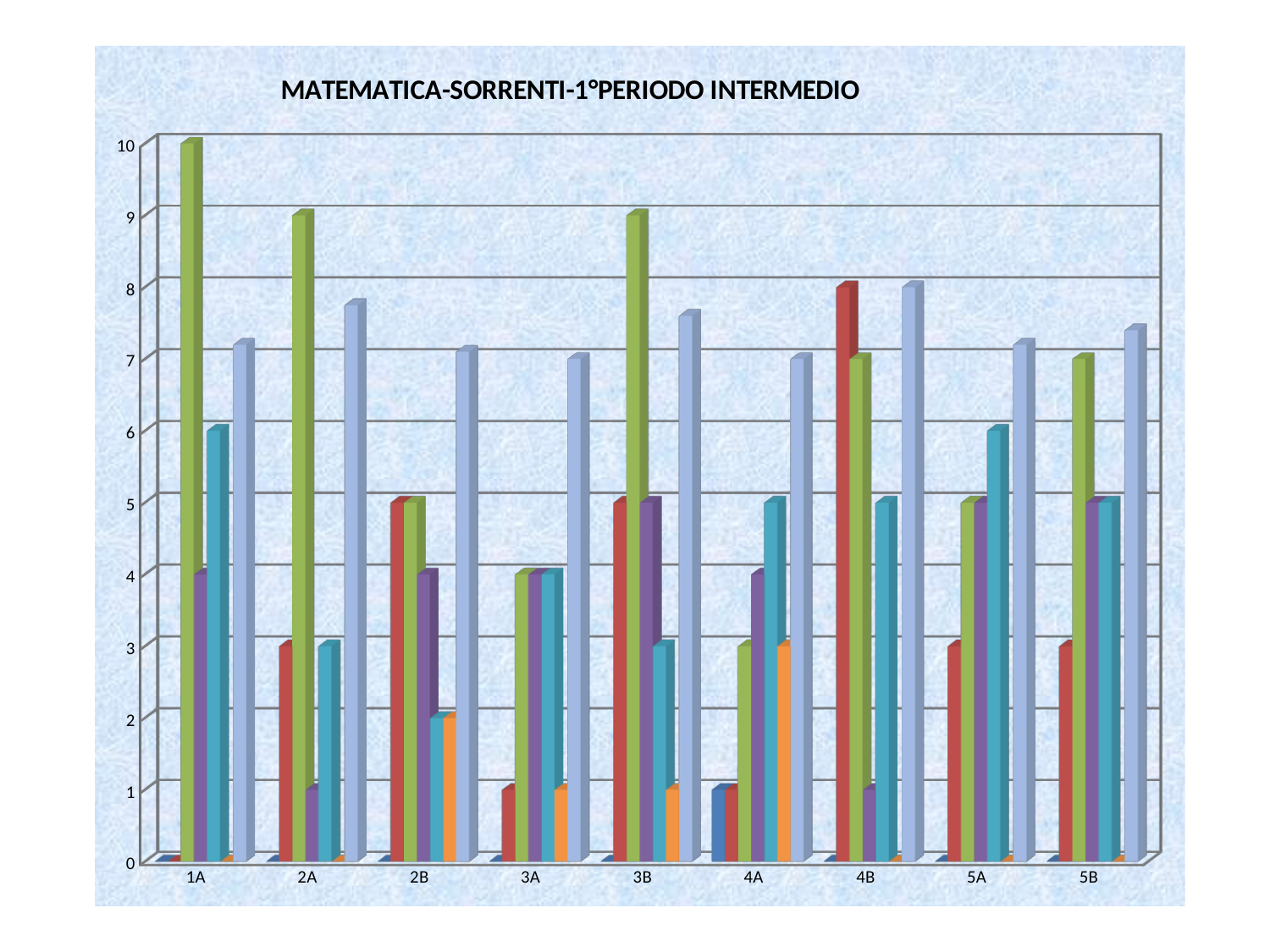
Which category contains the tallest bar in the chart? 1A What is the highest value shown on the vertical axis? 10 Is the tallest bar in category 3A greater or less than 8? less How many categories are shown on the x axis? 9 Is the tallest bar in category 4B greater or less than 7? greater What is the value of the tallest bar in category 1A? 10 What is the title of the chart? MATEMATICA-SORRENTI-1°PERIODO INTERMEDIO Which category has a taller maximum bar, 2A or 3A? 2A What kind of chart is shown on the slide? bar chart Is the tallest bar in category 5B greater or less than 6? greater Which category has a taller maximum bar, 3B or 2B? 3B